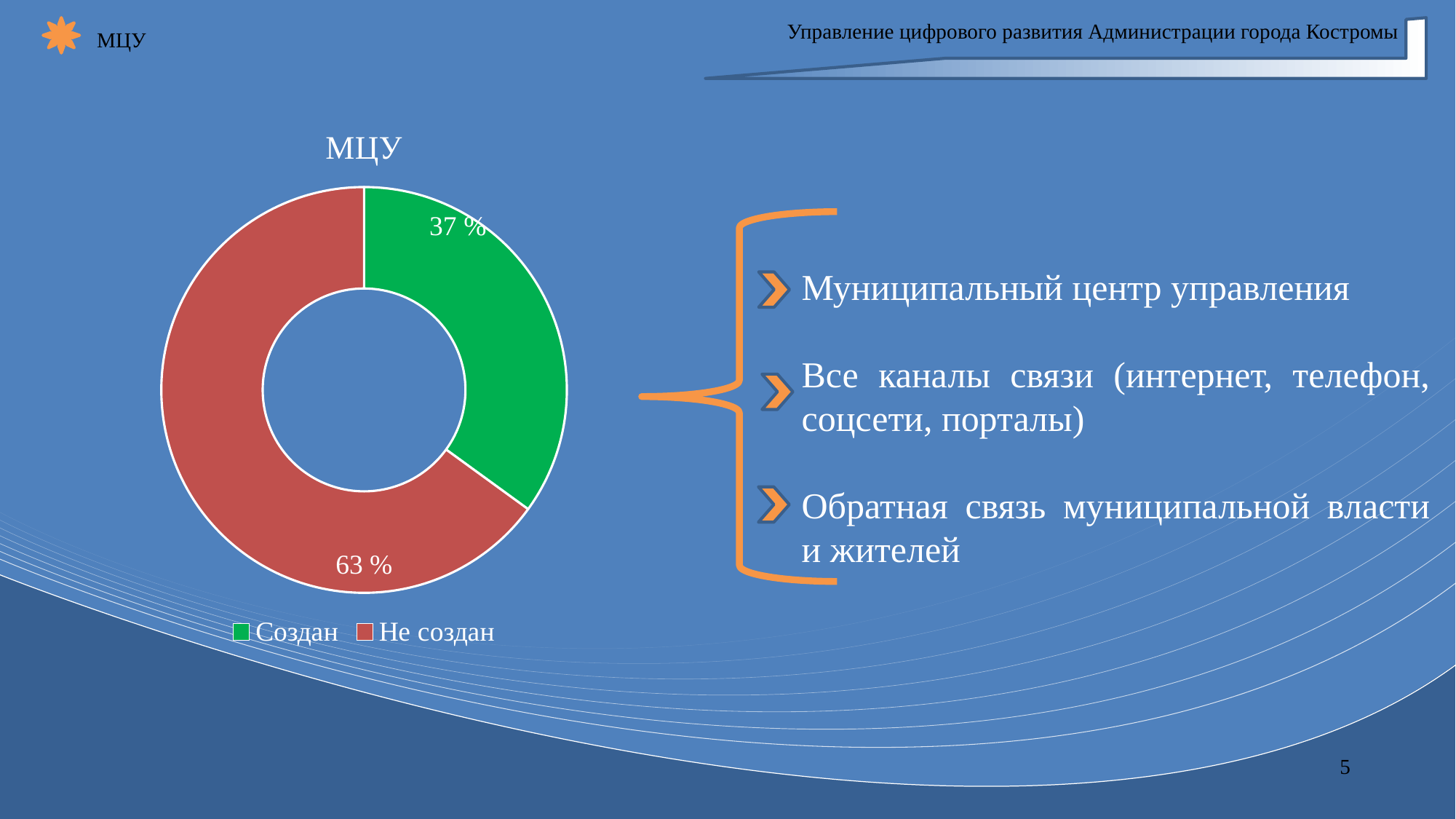
What kind of chart is shown on the slide? Doughnut (pie) chart How many categories does the МЦУ chart show? 2 What colour represents "Создан" in the МЦУ chart? Green How many entries does the legend of the МЦУ chart list? 2 What is the value for "Создан" in the МЦУ chart? 37 % Which category has the largest share in the МЦУ chart? Не создан Which category has the smallest share in the МЦУ chart? Создан What share of the МЦУ chart does the "Не создан" slice take? 63 % Which is larger in the МЦУ chart: "Создан" or "Не создан"? Не создан What is the difference between the "Не создан" and "Создан" shares in the МЦУ chart? 26 % What is the title of the chart on the slide? МЦУ What is the value for "Не создан" in the МЦУ chart? 63 %